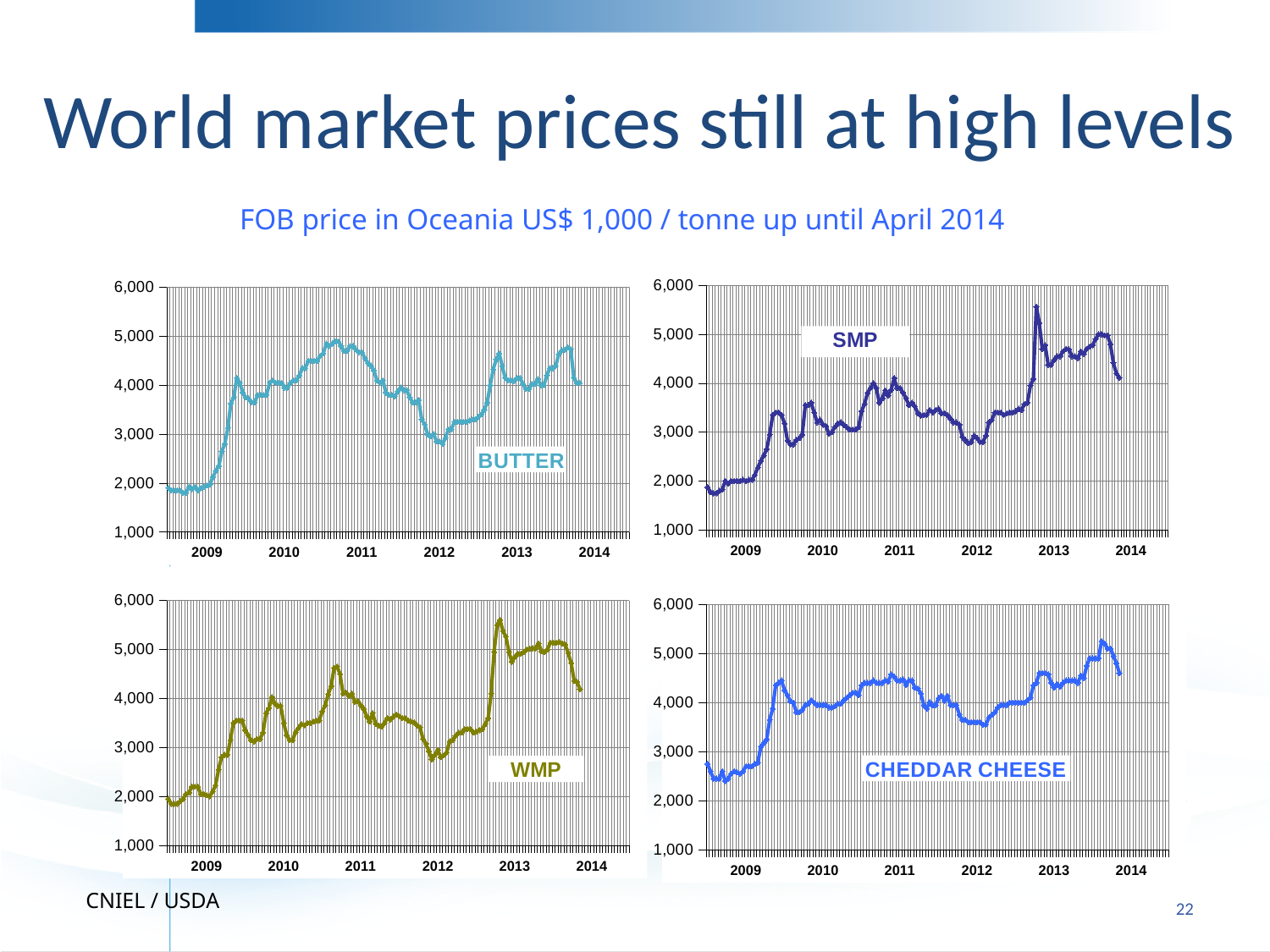
In the WMP chart, is the peak value reached in late 2012 greater or less than 5,000? greater In the BUTTER chart, do prices rise or fall between the start of 2009 and the start of 2010? rise In the CHEDDAR CHEESE chart, do prices rise or fall between the start of 2009 and the start of 2010? rise In the CHEDDAR CHEESE chart, is the value at the start of 2009 greater or less than 3,000? less In the SMP chart, is the lowest value during 2012 greater or less than 3,000? less What is the highest value shown on the y axis of the WMP chart? 6,000 Which four products are shown in the charts on the slide? BUTTER, SMP, WMP, CHEDDAR CHEESE What kind of chart is the BUTTER chart? line chart How many charts are shown on the slide? 4 In the SMP chart, do prices rise or fall from late 2013 into 2014? fall